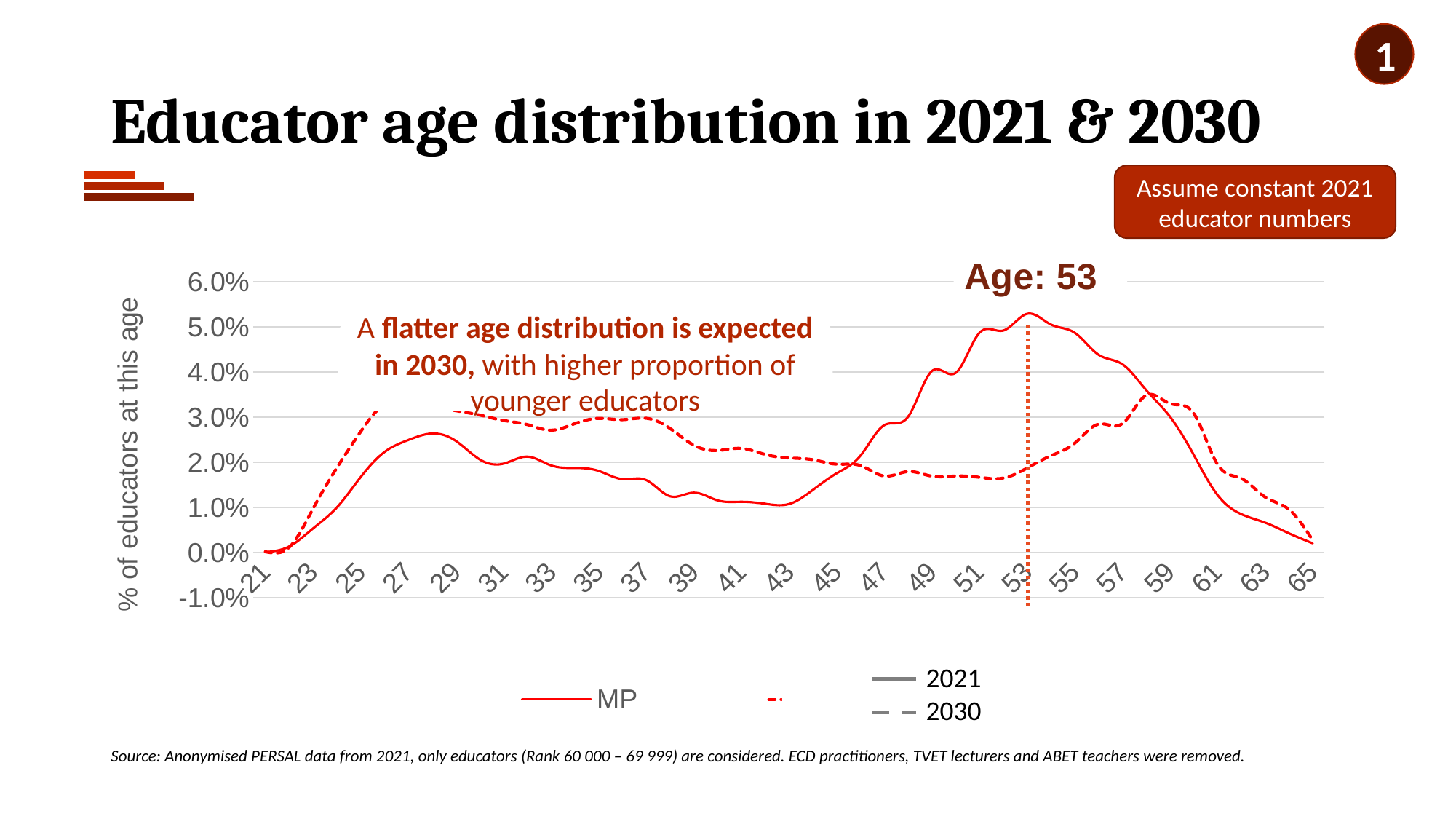
What is the title of the chart on the slide? Educator age distribution in 2021 & 2030 Does the solid 2021 line rise or fall between age 53 and age 65? Fall Is the value of the solid 2021 line at age 65 greater or less than 1.0%? less At which age does the solid 2021 line reach its highest value? 53 At age 53, which line has the higher value, the solid 2021 line or the dashed 2030 line? The solid 2021 line Is the value of the dashed 2030 line at age 53 greater or less than 2.0%? less Is the value of the dashed 2030 line at age 39 greater or less than 2.0%? greater What kind of chart is shown on the slide? Line chart What is the label of the vertical axis? % of educators at this age Does the solid 2021 line rise or fall between age 45 and age 53? Rise At age 37, which line has the higher value, the solid 2021 line or the dashed 2030 line? The dashed 2030 line